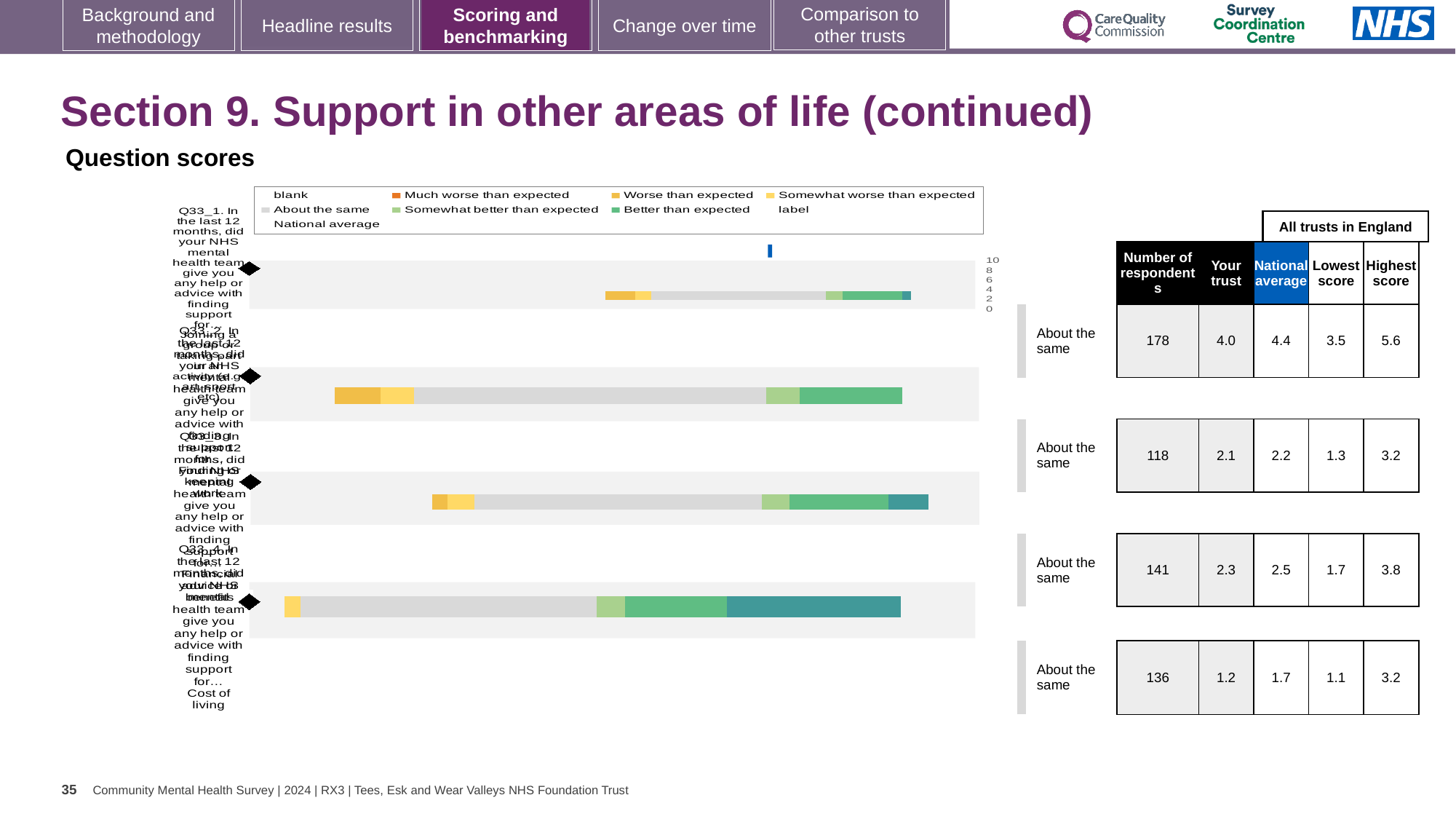
In the table next to the chart, which row has the lowest number of respondents? the second row (Q33_2), 118 In the table next to the chart, what is the difference between the national average and 'Your trust' score for the fourth row (Q33_4)? 0.5 How many entries does the chart's legend list? 9 What kind of chart is shown on the slide? bar chart In the table next to the chart, what is the 'Your trust' score for the first row (Q33_1)? 4.0 In the table next to the chart, is the 'Your trust' score for the third row (Q33_3) larger or smaller than the national average? smaller How many bars (questions) are plotted in the chart? 4 In the chart's legend, which colour represents 'About the same'? grey In the table next to the chart, what is the national average for the fourth row (Q33_4)? 1.7 In the table next to the chart, what is the number of respondents for the first row (Q33_1)? 178 In the table next to the chart, which row has the highest 'Your trust' score? the first row (Q33_1), 4.0